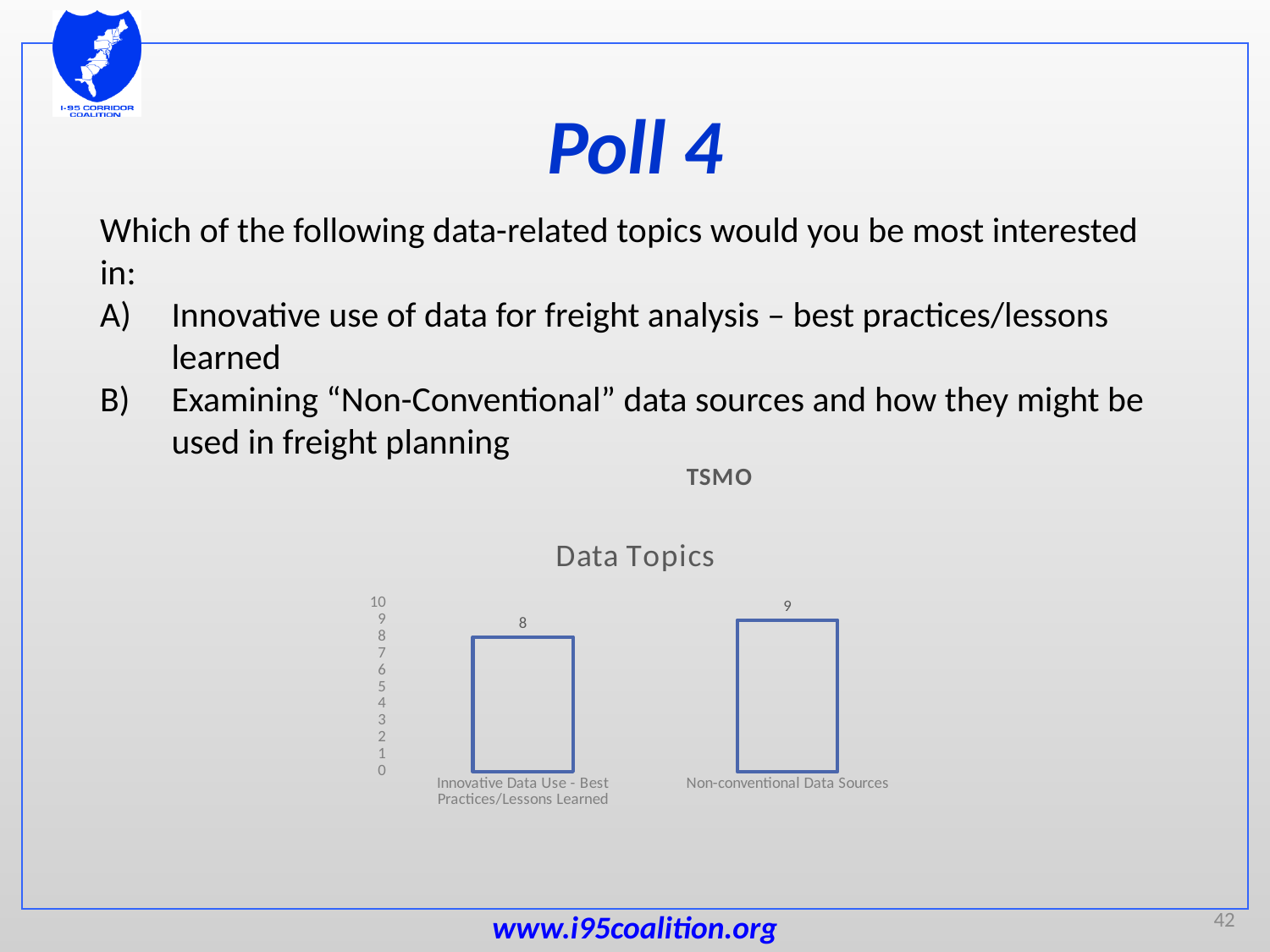
What is the value for Non-conventional Data Sources? 9 How many categories are shown in the chart? 2 What is the value for Innovative Data Use - Best Practices/Lessons Learned? 8 Is the value for Innovative Data Use - Best Practices/Lessons Learned greater or less than 5? greater Which category has the highest value? Non-conventional Data Sources Is the value for Non-conventional Data Sources greater or less than 10? less Which is larger: the value for Innovative Data Use - Best Practices/Lessons Learned or the value for Non-conventional Data Sources? Non-conventional Data Sources Which category has the lowest value? Innovative Data Use - Best Practices/Lessons Learned What is the difference between the values for Non-conventional Data Sources and Innovative Data Use - Best Practices/Lessons Learned? 1 What is the maximum value shown on the vertical axis? 10 What kind of chart is shown on the slide? bar chart What is the title of the chart? Data Topics